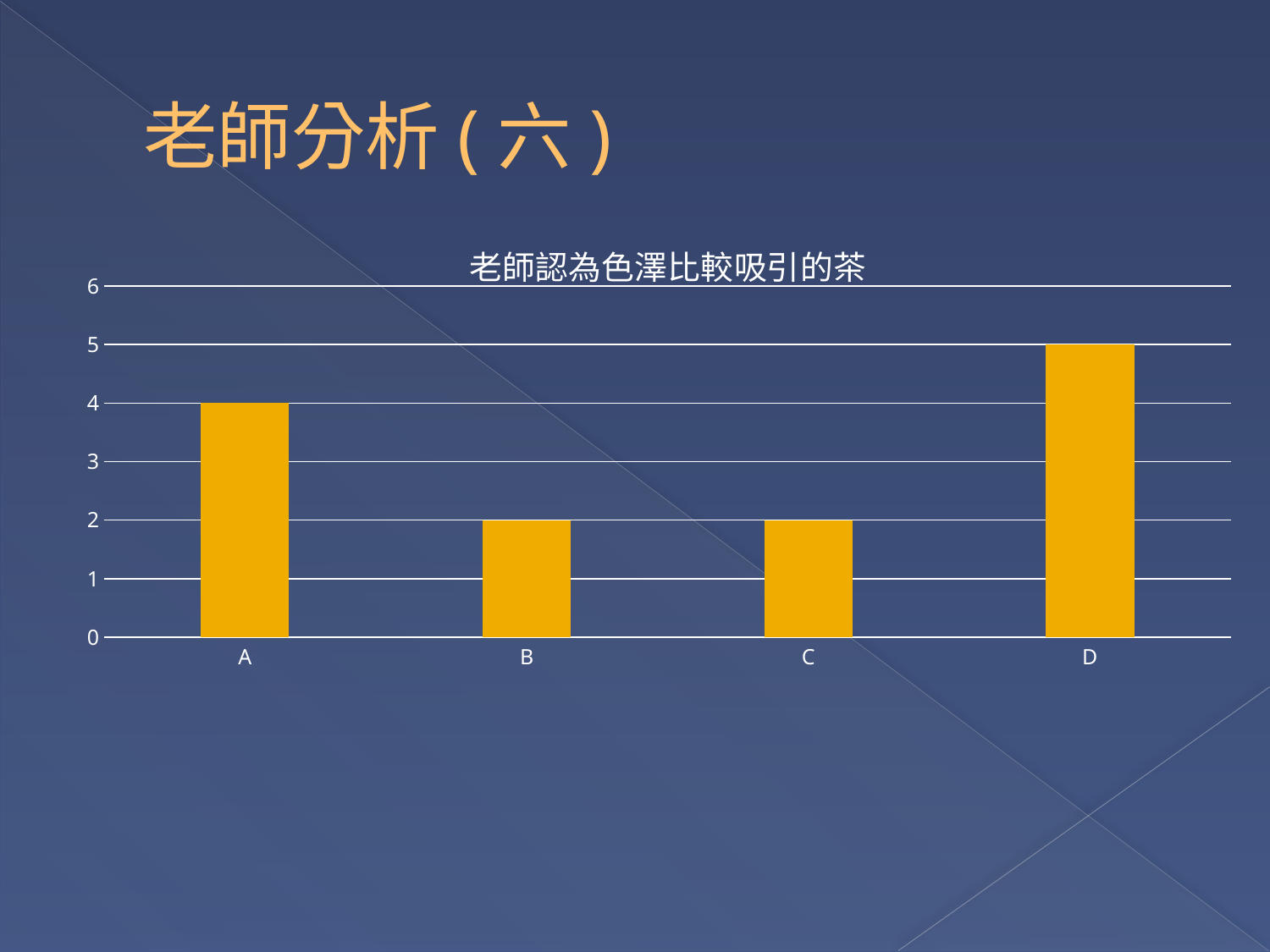
What is the value for A? 4 Is the value for D greater or less than 3? greater Which is larger, the value for A or the value for B? A What is the difference between the values for D and A? 1 What is the highest value shown on the vertical axis? 6 How many categories are shown on the x axis? 4 What kind of chart is shown on the slide? bar chart What is the value for B? 2 What is the value for D? 5 What is the difference between the values for A and C? 2 Which category has the highest value? D What is the title of the chart? 老師認為色澤比較吸引的茶